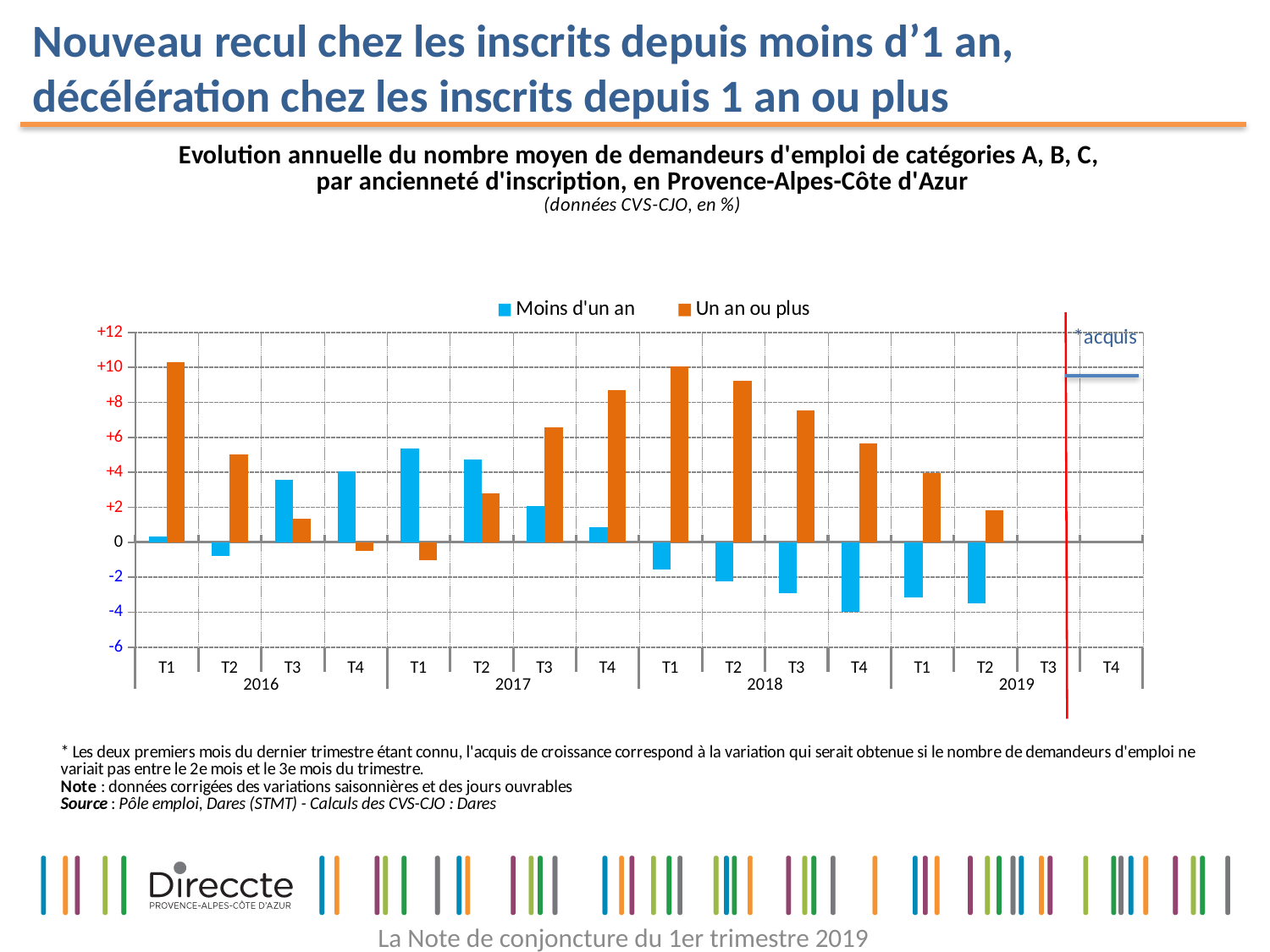
How many series does the legend list? 2 Which series is shown in orange? Un an ou plus In T2 2018, which series has the larger value, 'Moins d'un an' or 'Un an ou plus'? Un an ou plus Do the values for 'Un an ou plus' rise or fall from T1 2018 to T2 2019? fall Is the value for 'Moins d'un an' in T4 2018 greater or less than -2? less How many years are labelled on the x axis? 4 In T1 2017, which series has the larger value, 'Moins d'un an' or 'Un an ou plus'? Moins d'un an Which series is shown in blue? Moins d'un an Is the value for 'Un an ou plus' in T1 2018 greater or less than +8? greater What type of chart is shown on the slide? bar chart Is the value for 'Un an ou plus' in T1 2016 greater or less than +8? greater